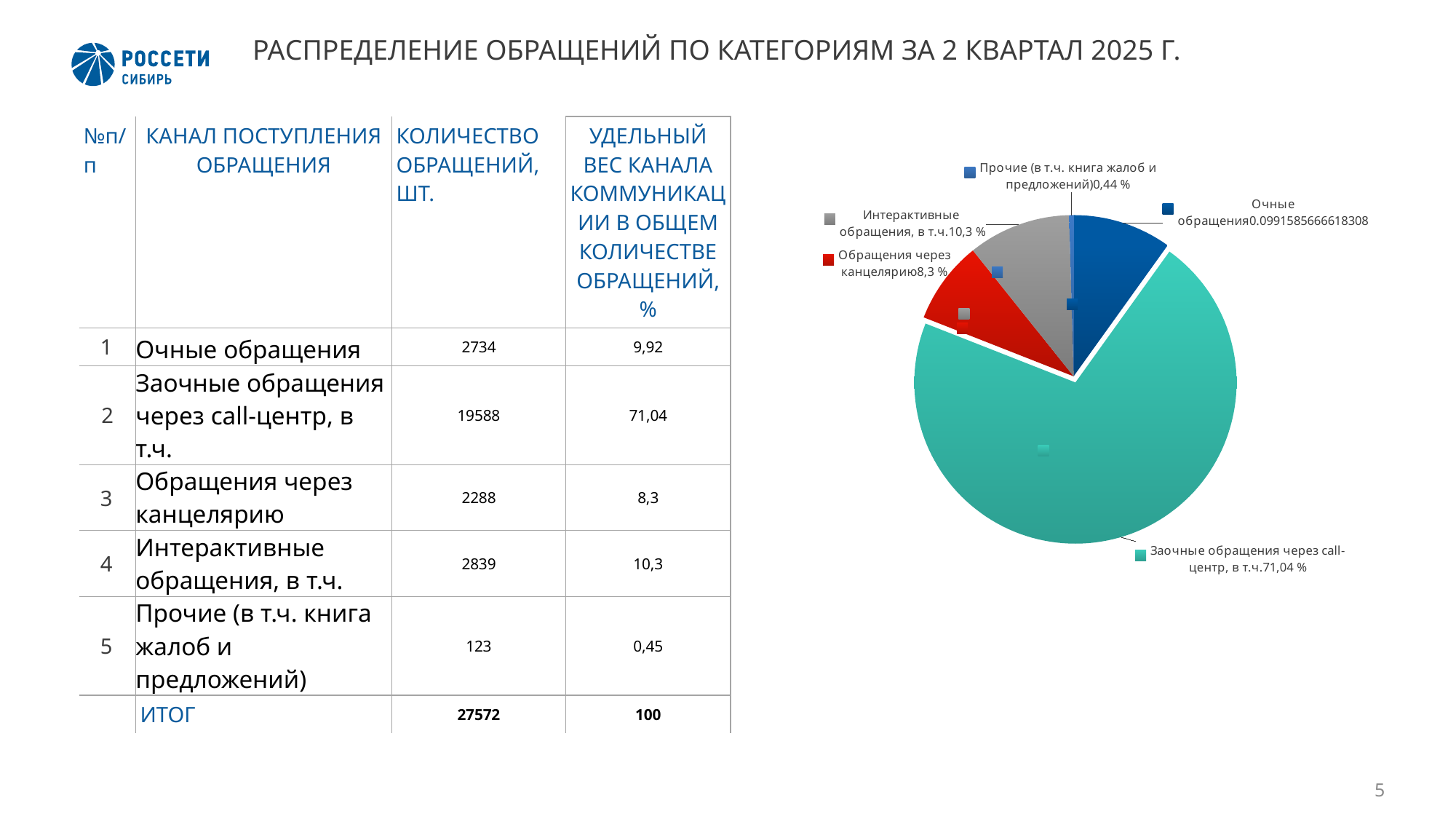
Which category has the largest slice in the pie chart? Заочные обращения через call-центр, в т.ч. What share of the pie is labelled for Обращения через канцелярию? 8,3 % What share of the pie is labelled for Прочие (в т.ч. книга жалоб и предложений)? 0,44 % By how many percentage points does the Интерактивные обращения, в т.ч. slice exceed the Обращения через канцелярию slice? 2 Which category has the smallest slice in the pie chart? Прочие (в т.ч. книга жалоб и предложений) By how many percentage points does the Заочные обращения через call-центр, в т.ч. slice exceed the Интерактивные обращения, в т.ч. slice? 60,74 What kind of chart is shown on the slide? pie chart What share of the pie is labelled for Интерактивные обращения, в т.ч.? 10,3 % What colour is the largest slice of the pie chart? teal Which slice is larger in the pie chart: Интерактивные обращения, в т.ч. or Обращения через канцелярию? Интерактивные обращения, в т.ч. How many slices does the pie chart have? 5